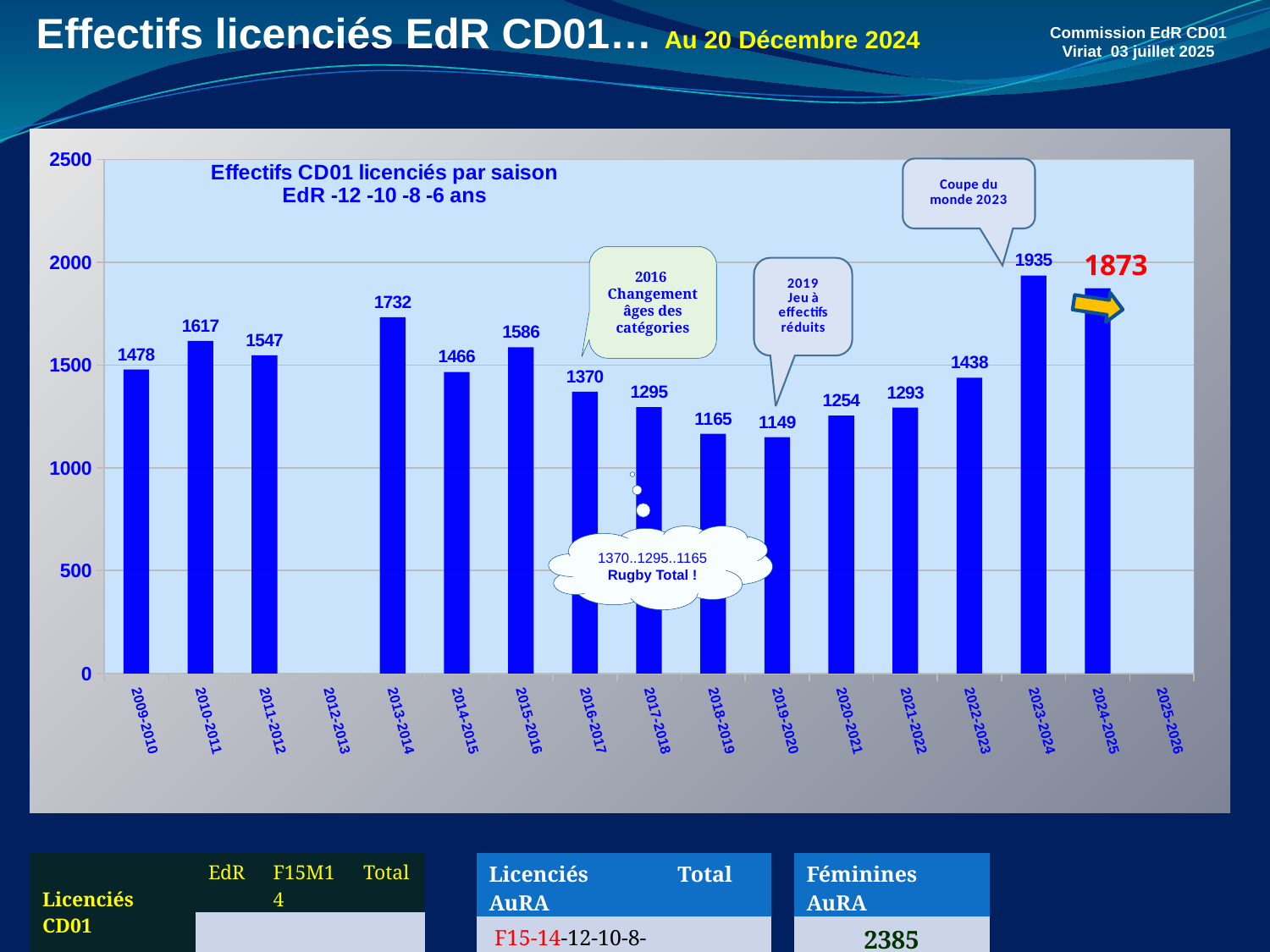
Do the values rise or fall from the 2019-2020 season to the 2023-2024 season? rise What is the value for the 2019-2020 season? 1149 Is the value for 2022-2023 greater or less than 1500? less What is the title of the chart? Effectifs CD01 licenciés par saison EdR -12 -10 -8 -6 ans Which season has the highest number of licensed members? 2023-2024 How many bars are plotted in the chart? 15 Which season has the lowest number of licensed members? 2019-2020 What is the value for the 2013-2014 season? 1732 What is the value for the 2023-2024 season? 1935 Which is larger, the value for 2010-2011 or the value for 2011-2012? 2010-2011 What kind of chart is shown on the slide? bar chart What is the difference between the 2023-2024 value and the 2024-2025 value? 62